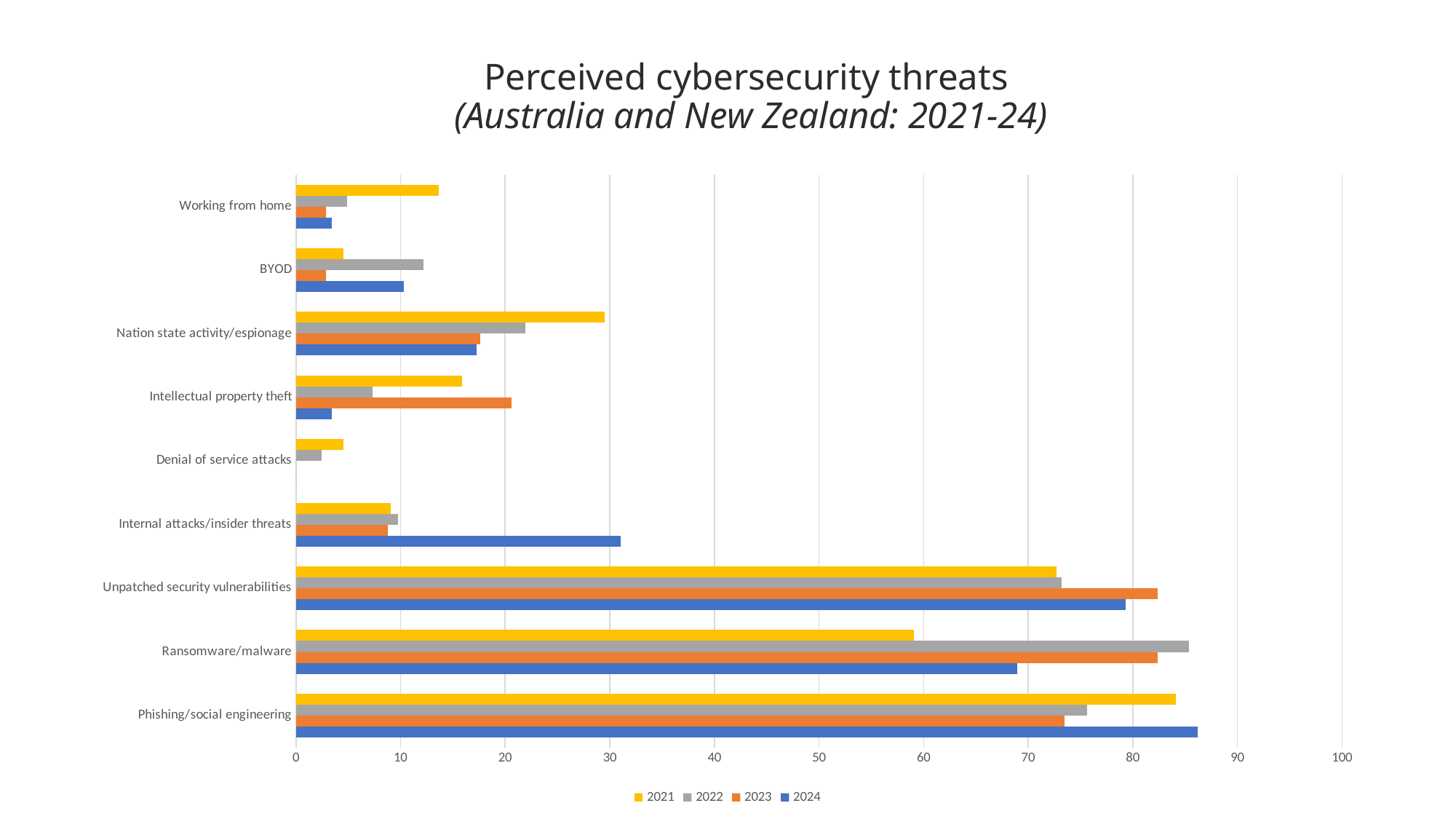
How many series does the legend list? 4 Which threat category has the highest value for 2022? Ransomware/malware Is the 2021 value for Nation state activity/espionage greater or less than 20? greater What kind of chart is shown on the slide? bar chart Is the 2024 value for Internal attacks/insider threats greater or less than 20? greater How many threat categories are plotted on the chart? 9 Is the 2021 value for Ransomware/malware greater or less than 70? less What are the entries listed in the legend? 2021, 2022, 2023, 2024 Which threat category has the highest value for 2024? Phishing/social engineering For Ransomware/malware, which is larger: the 2021 value or the 2024 value? 2024 For Intellectual property theft, which is larger: the 2021 value or the 2023 value? 2023